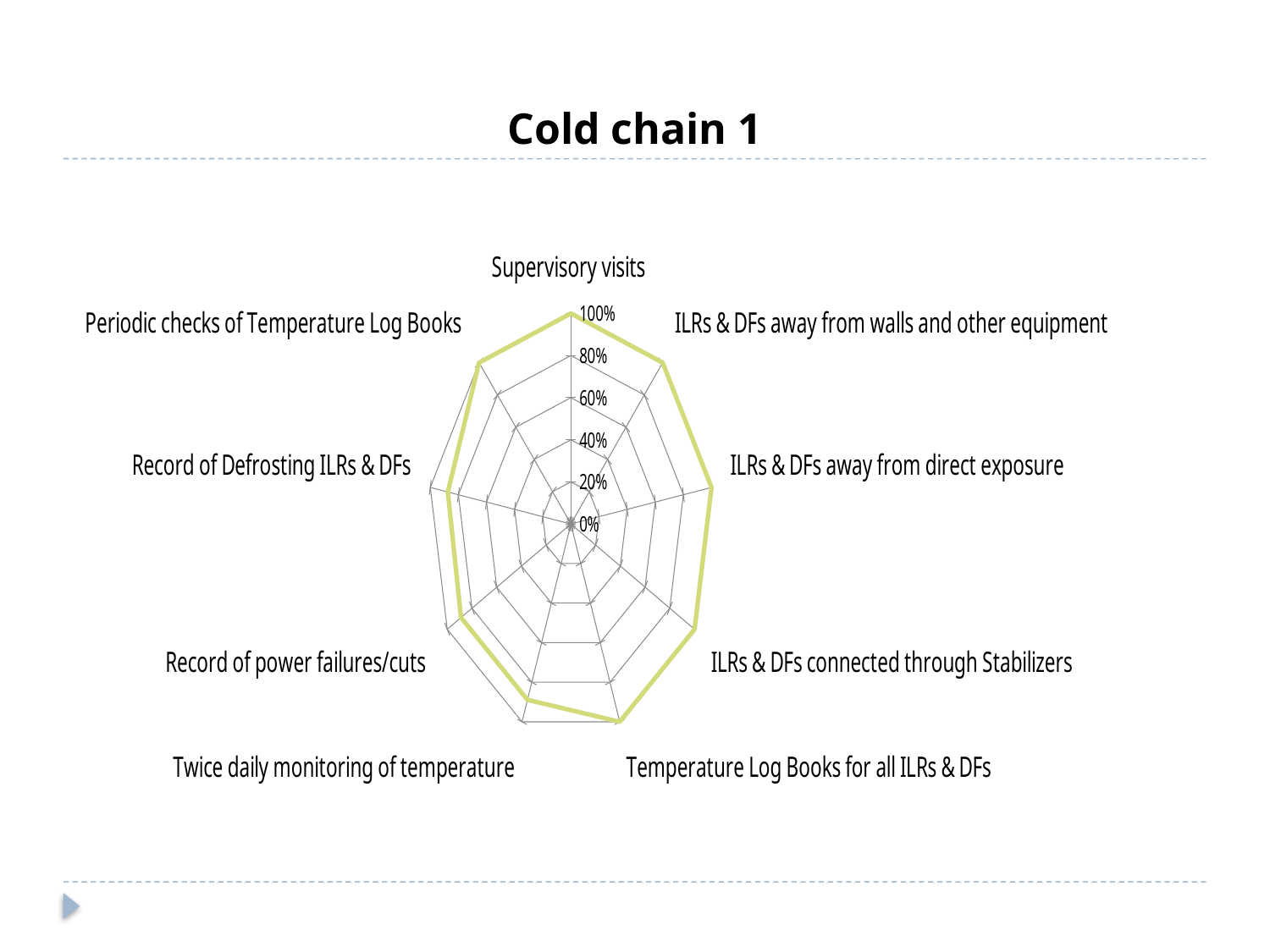
Which category is plotted at the top of the radar chart? Supervisory visits What is the value for Supervisory visits? 100% Is the value for Record of power failures/cuts greater or less than 60%? greater How many categories (axes) does the radar chart have? 9 What is the highest value shown on the radar chart's axis scale? 100% Is the value for Twice daily monitoring of temperature greater or less than 80%? greater Is the value for Record of Defrosting ILRs & DFs greater or less than 60%? greater What is the title of the slide containing the radar chart? Cold chain 1 What kind of chart is shown on the slide? Radar chart